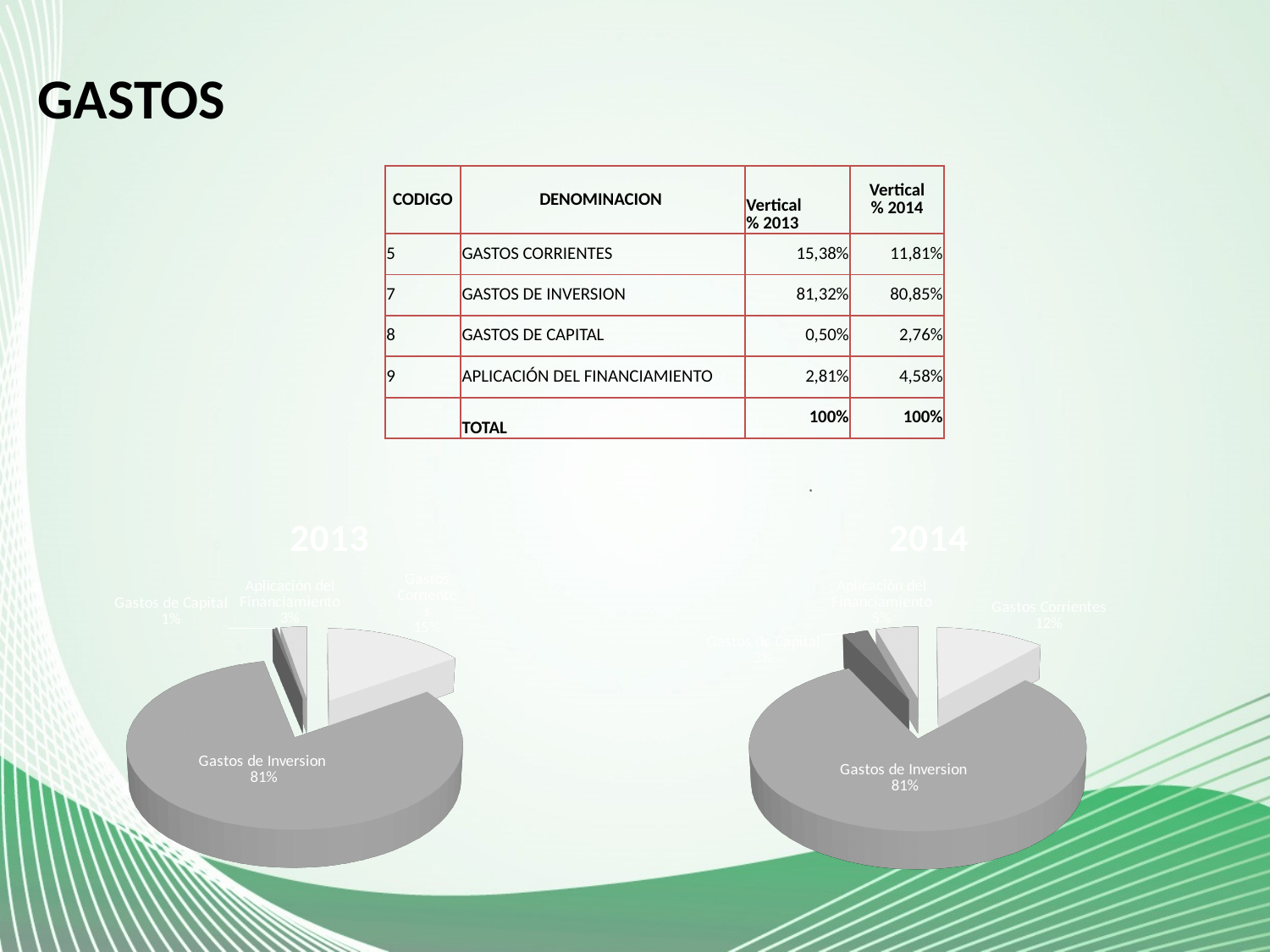
What is the title of the pie chart on the left of the slide? 2013 What is the title of the pie chart on the right of the slide? 2014 What kind of chart is the 2013 chart on the slide? pie chart In the 2014 pie chart, what share does Gastos de Inversion have? 81% How many slices does the 2014 pie chart have? 4 How many slices does the 2013 pie chart have? 4 In the 2013 pie chart, which is larger, the slice for Gastos de Inversion or the slice for Gastos Corrientes? Gastos de Inversion In the 2014 pie chart, what share does Gastos Corrientes have? 12% In the 2013 pie chart, which category has the largest slice? Gastos de Inversion In the 2013 pie chart, what share does Gastos de Inversion have? 81% In the 2014 pie chart, which category has the largest slice? Gastos de Inversion In the 2013 pie chart, what share does Gastos Corrientes have? 15%